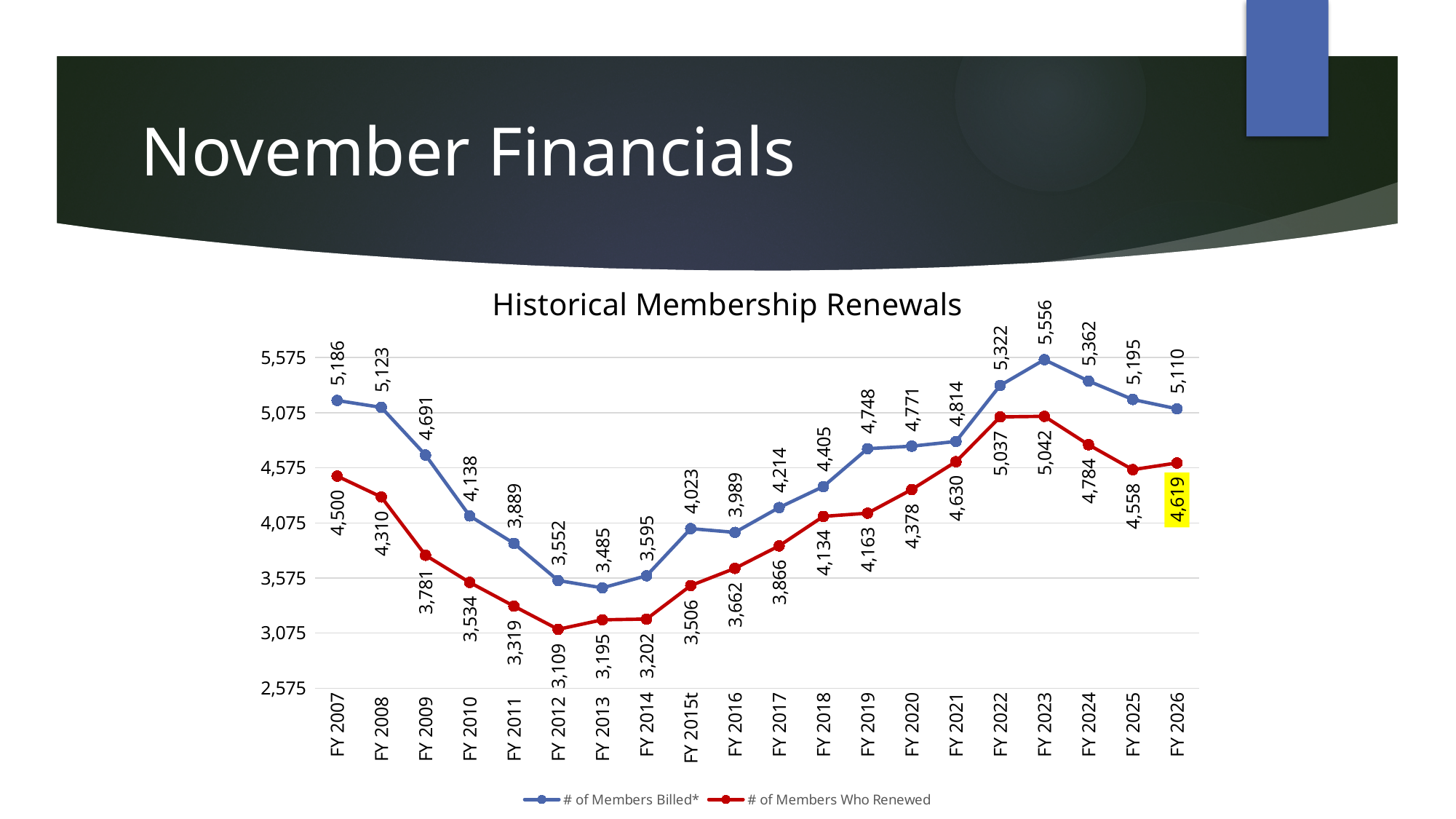
What is the difference between # of Members Billed* and # of Members Who Renewed in FY 2026? 491 How many series does the legend list? 2 How many fiscal years are plotted on the x axis? 20 Does # of Members Billed* rise or fall from FY 2023 to FY 2026? Fall What is the value of # of Members Who Renewed for FY 2026? 4,619 Is the value of # of Members Billed* for FY 2013 greater or less than 3,575? less What is the value of # of Members Billed* for FY 2023? 5,556 In which fiscal year is # of Members Who Renewed the lowest? FY 2012 Which is larger: # of Members Who Renewed in FY 2022 or in FY 2024? FY 2022 What type of chart is shown on the slide? Line chart What is the title of the chart? Historical Membership Renewals In which fiscal year is # of Members Billed* the highest? FY 2023